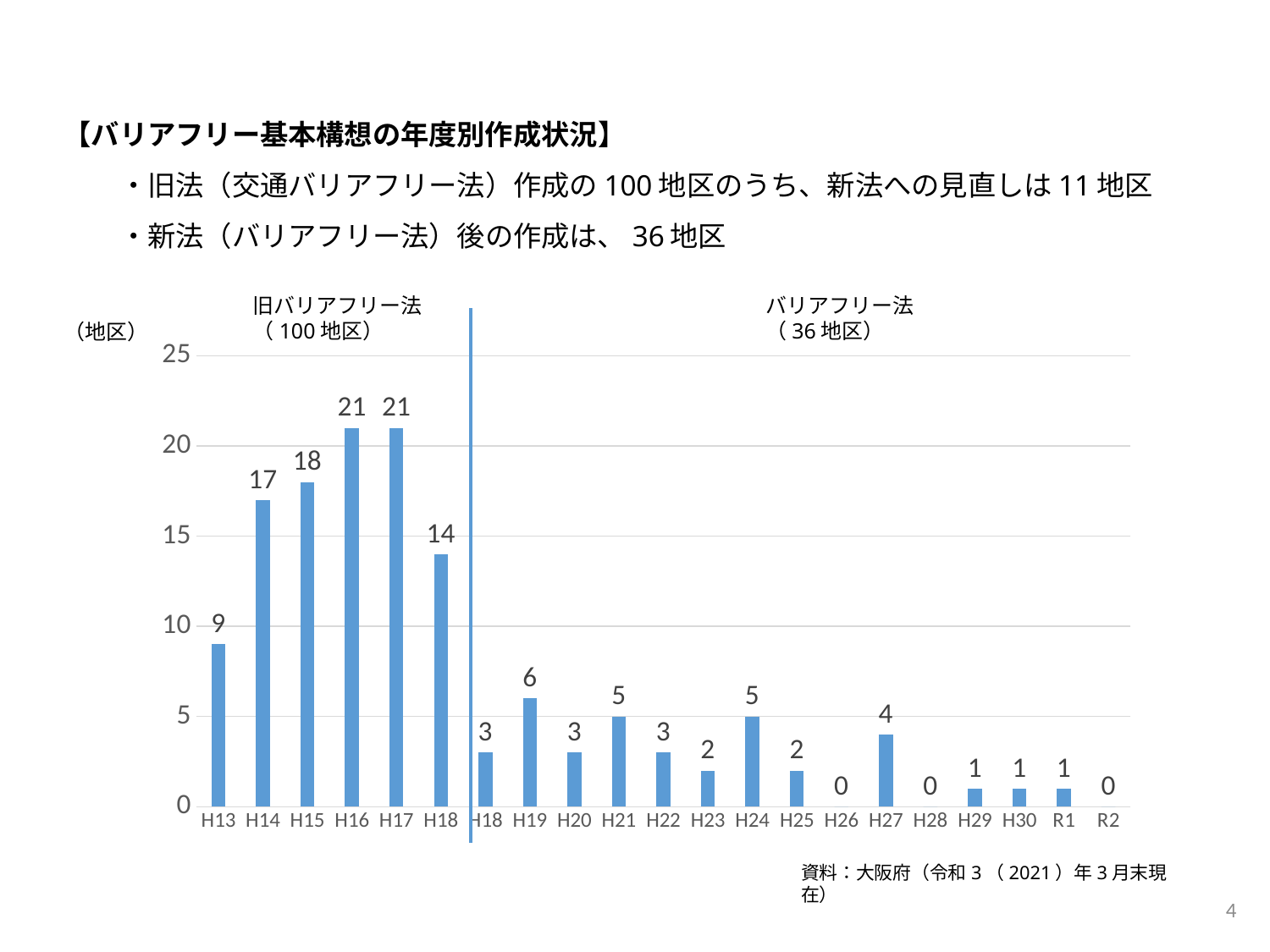
What unit label is shown at the top of the vertical axis? （地区） What is the value for H15? 18 Which has a larger value, H21 or H23? H21 How many bars (categories) are plotted along the x axis? 21 Is the value for H16 greater or less than 20? greater What is the value for H27? 4 What is the value for H13? 9 What is the difference between the values for H14 and H13? 8 What is the highest value shown by any bar in the chart? 21 What is the value for R2? 0 What kind of chart is shown on the slide? bar chart What is the value for H19? 6